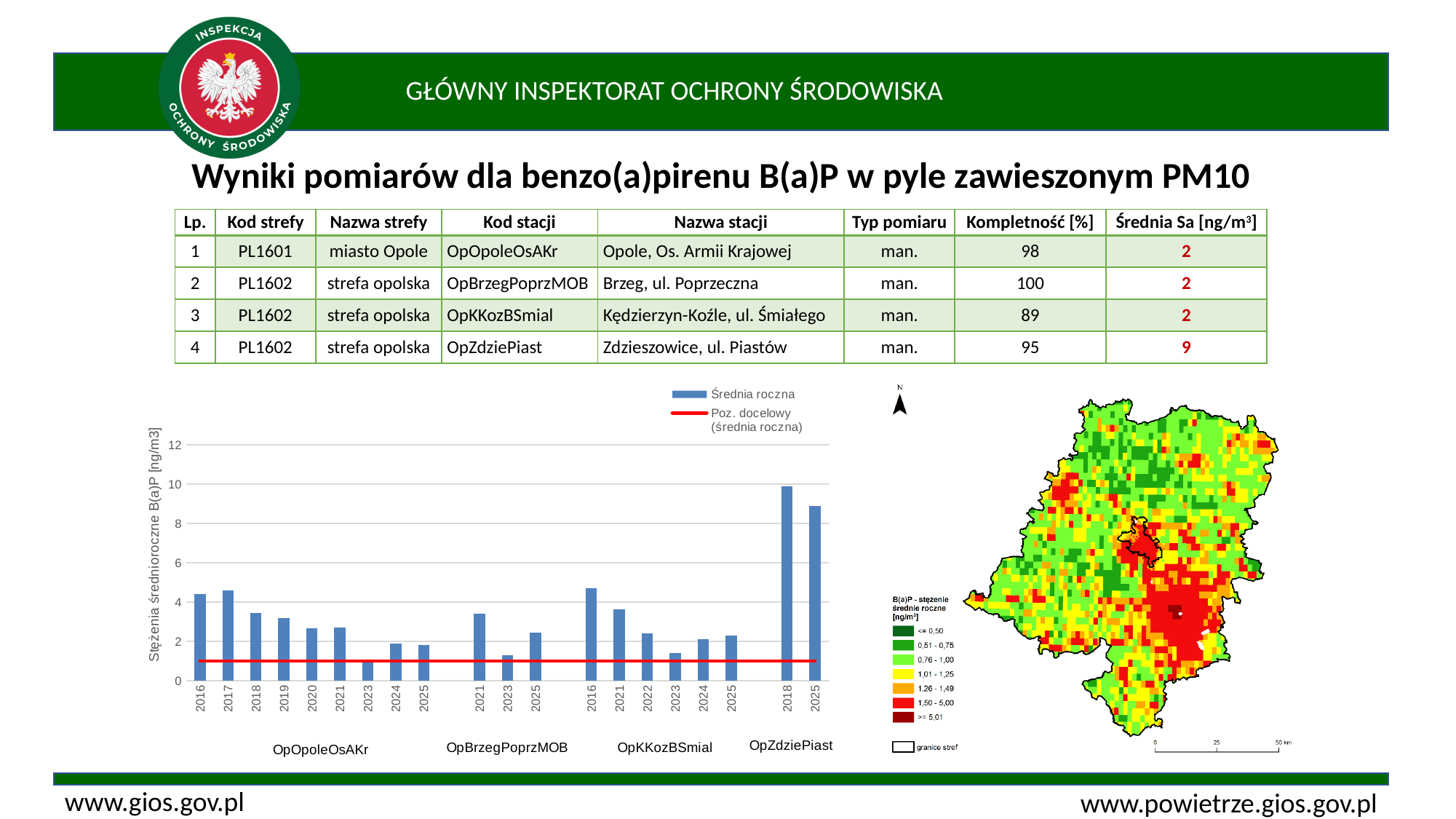
How many entries does the legend of the bar chart list? 2 Which is larger in the bar chart: OpZdziePiast 2018 or OpZdziePiast 2025? OpZdziePiast 2018 What kind of chart is shown on the left of the slide? bar chart Which bar is the highest in the bar chart? OpZdziePiast 2018 Within the OpOpoleOsAKr group, which year has the lowest bar? 2023 Is the value for OpZdziePiast in 2018 greater or less than 8? greater What is the y-axis label of the bar chart? Stężenia średnioroczne B(a)P [ng/m3] How many bars are plotted in the bar chart in total? 20 How many station groups are shown along the x axis of the bar chart? 4 Is the value for OpOpoleOsAKr in 2016 greater or less than 4? greater Do the values for OpOpoleOsAKr generally rise or fall from 2016 to 2025? fall What are the two legend entries of the bar chart? Średnia roczna; Poz. docelowy (średnia roczna)